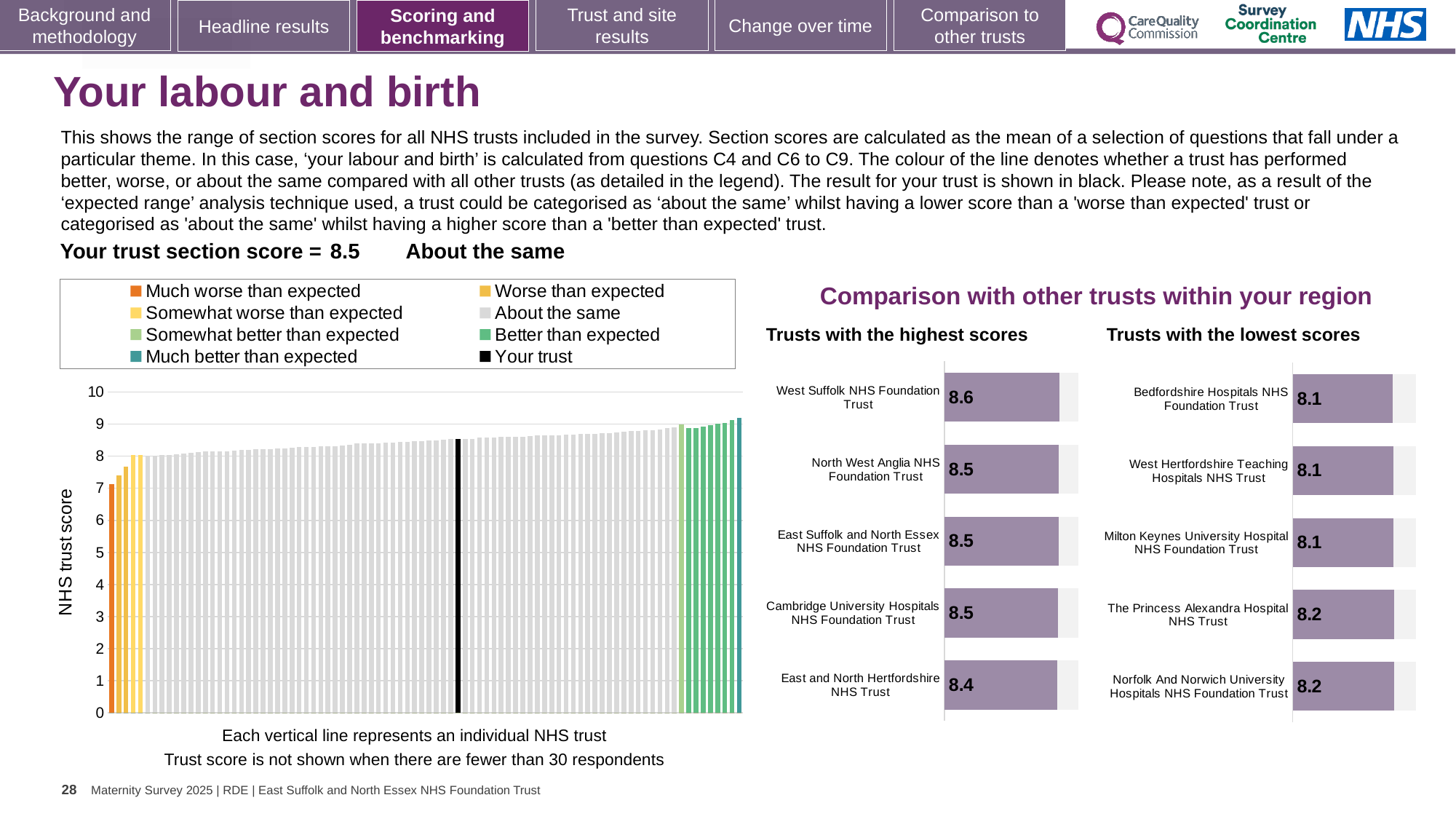
In the 'Trusts with the highest scores' chart, what is the difference between the scores of West Suffolk NHS Foundation Trust and East and North Hertfordshire NHS Trust? 0.2 In the 'NHS trust score' chart on the left, is the value of the lowest (orange) bar greater or less than 8? less In the 'Trusts with the lowest scores' chart, what is the score for Bedfordshire Hospitals NHS Foundation Trust? 8.1 In the 'Trusts with the highest scores' chart, what is the score for West Suffolk NHS Foundation Trust? 8.6 In the 'Trusts with the highest scores' chart, which trust has the highest score? West Suffolk NHS Foundation Trust In the 'Trusts with the lowest scores' chart, which is larger: the score for Norfolk And Norwich University Hospitals NHS Foundation Trust or Milton Keynes University Hospital NHS Foundation Trust? Norfolk And Norwich University Hospitals NHS Foundation Trust In the 'NHS trust score' chart on the left, do the bar values rise or fall from left to right along the x axis? rise In the 'NHS trust score' chart on the left, what is the section score for your trust (the black bar)? 8.5 In the 'Trusts with the highest scores' chart, what is the score for East and North Hertfordshire NHS Trust? 8.4 In the 'Trusts with the lowest scores' chart, what is the score for The Princess Alexandra Hospital NHS Trust? 8.2 In the 'Trusts with the lowest scores' chart, how many trusts are shown? 5 How many entries does the legend above the 'NHS trust score' chart list? 8